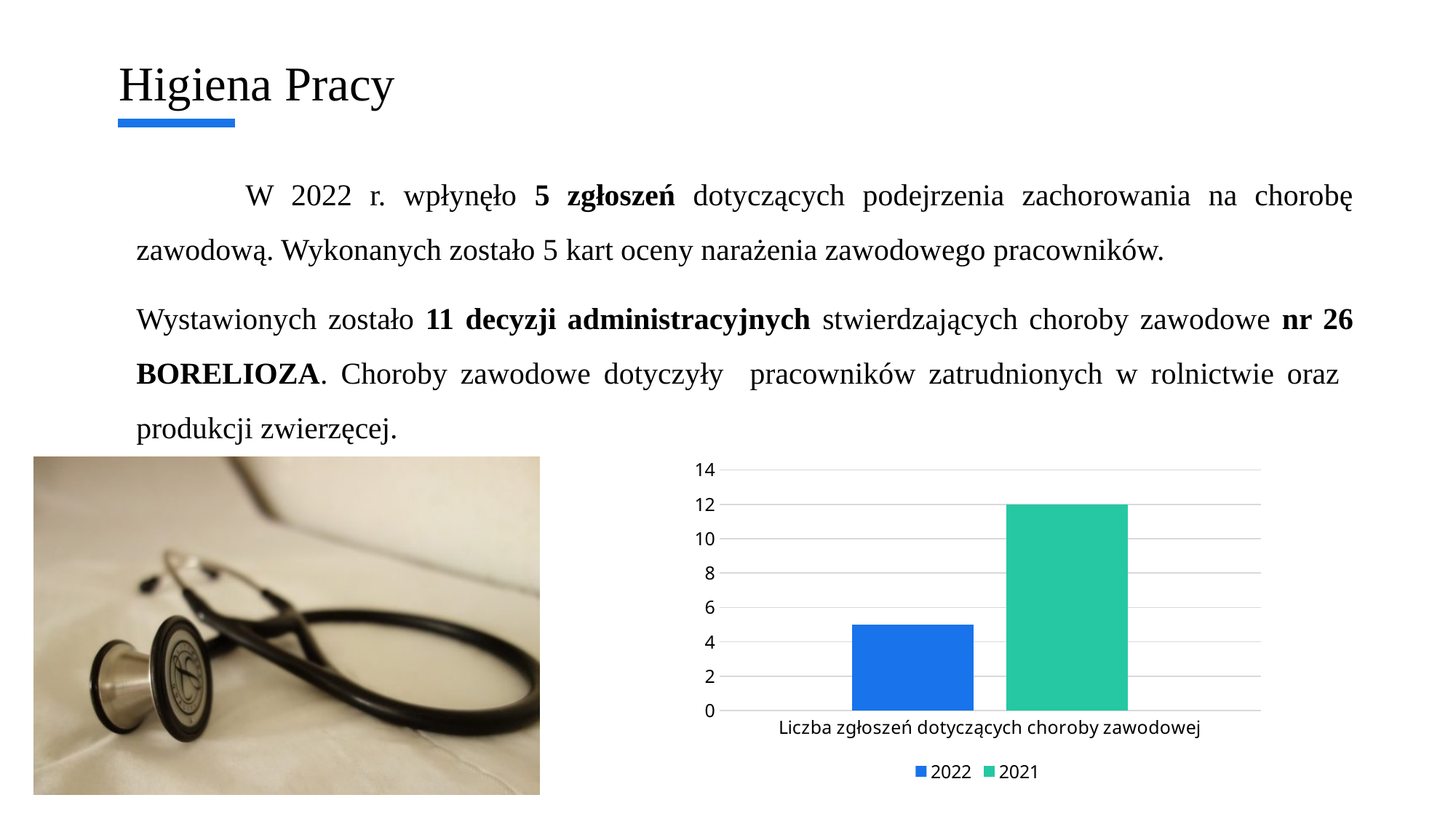
Is the value of the 2021 bar greater or less than 10? greater Which series has the lowest bar in the chart? 2022 What kind of chart is shown on the slide? bar chart Which years are listed in the chart legend? 2022 and 2021 Is the value of the 2022 bar greater or less than 6? less What is the category label on the x axis of the chart? Liczba zgłoszeń dotyczących choroby zawodowej What is the value of the 2021 bar in the chart? 12 How many series does the chart legend list? 2 Which series has the higher bar, 2022 or 2021? 2021 What is the highest value shown on the chart's y axis? 14 Is the value of the 2022 bar greater or less than 4? greater How many categories are shown on the x axis of the chart? 1